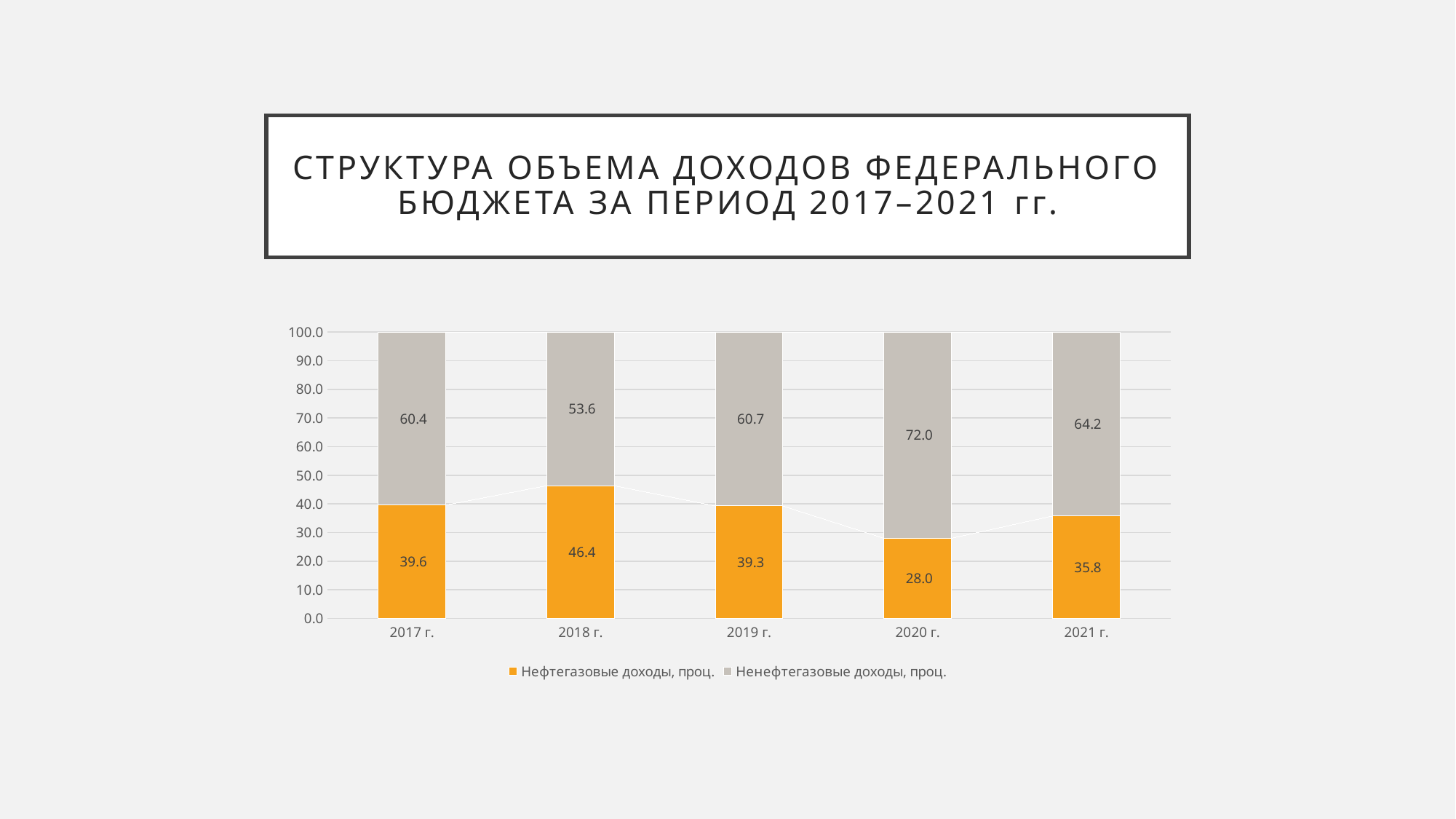
How many series does the legend list? 2 What kind of chart is shown on the slide? Stacked bar chart In which year is Нефтегазовые доходы, проц. the lowest? 2020 г. What is the value of Нефтегазовые доходы, проц. for 2018 г.? 46.4 In which year is Нефтегазовые доходы, проц. the highest? 2018 г. Which is larger: Нефтегазовые доходы, проц. in 2017 г. or in 2021 г.? 2017 г. What is the difference between Ненефтегазовые доходы, проц. and Нефтегазовые доходы, проц. in 2020 г.? 44.0 How many years are shown on the x axis? 5 What is the total of the stacked bar for 2019 г.? 100.0 What is the value of Ненефтегазовые доходы, проц. for 2020 г.? 72.0 What is the value of Нефтегазовые доходы, проц. for 2021 г.? 35.8 In which year is Ненефтегазовые доходы, проц. the highest? 2020 г.